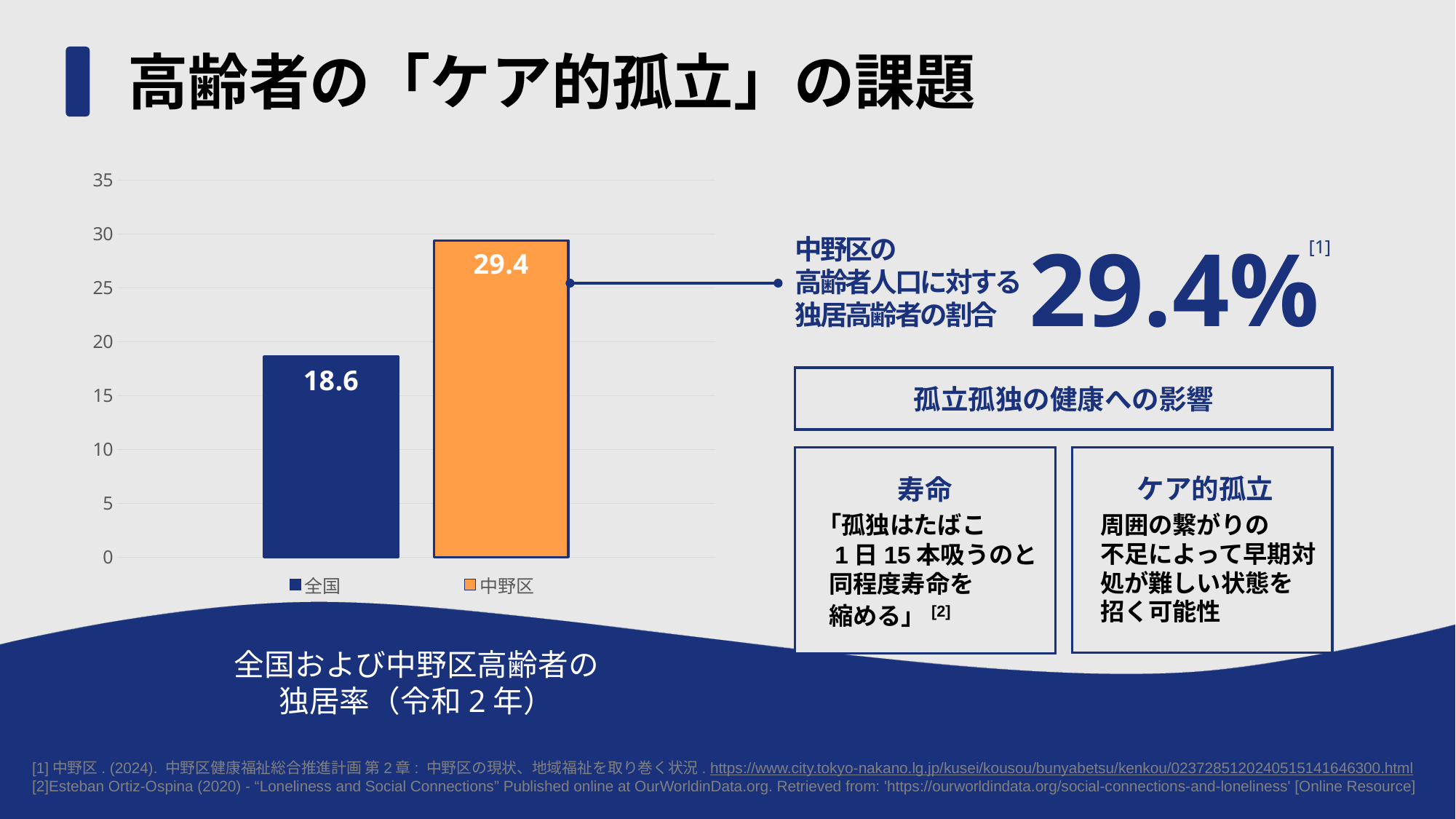
What kind of chart is shown on the slide? bar chart Is the value for 中野区 greater or less than 25? greater What is the difference between the values for 中野区 and 全国? 10.8 What is the title of the chart shown below the bars? 全国および中野区高齢者の独居率（令和2年） Is the value for 全国 greater or less than 20? less Which category has the higher value, 全国 or 中野区? 中野区 What is the value for 全国 in the bar chart? 18.6 What is the value for 中野区 in the bar chart? 29.4 How many bars are shown in the chart? 2 Which category has the lowest value in the bar chart? 全国 How many entries does the chart legend list? 2 What colour is the bar for 中野区? orange